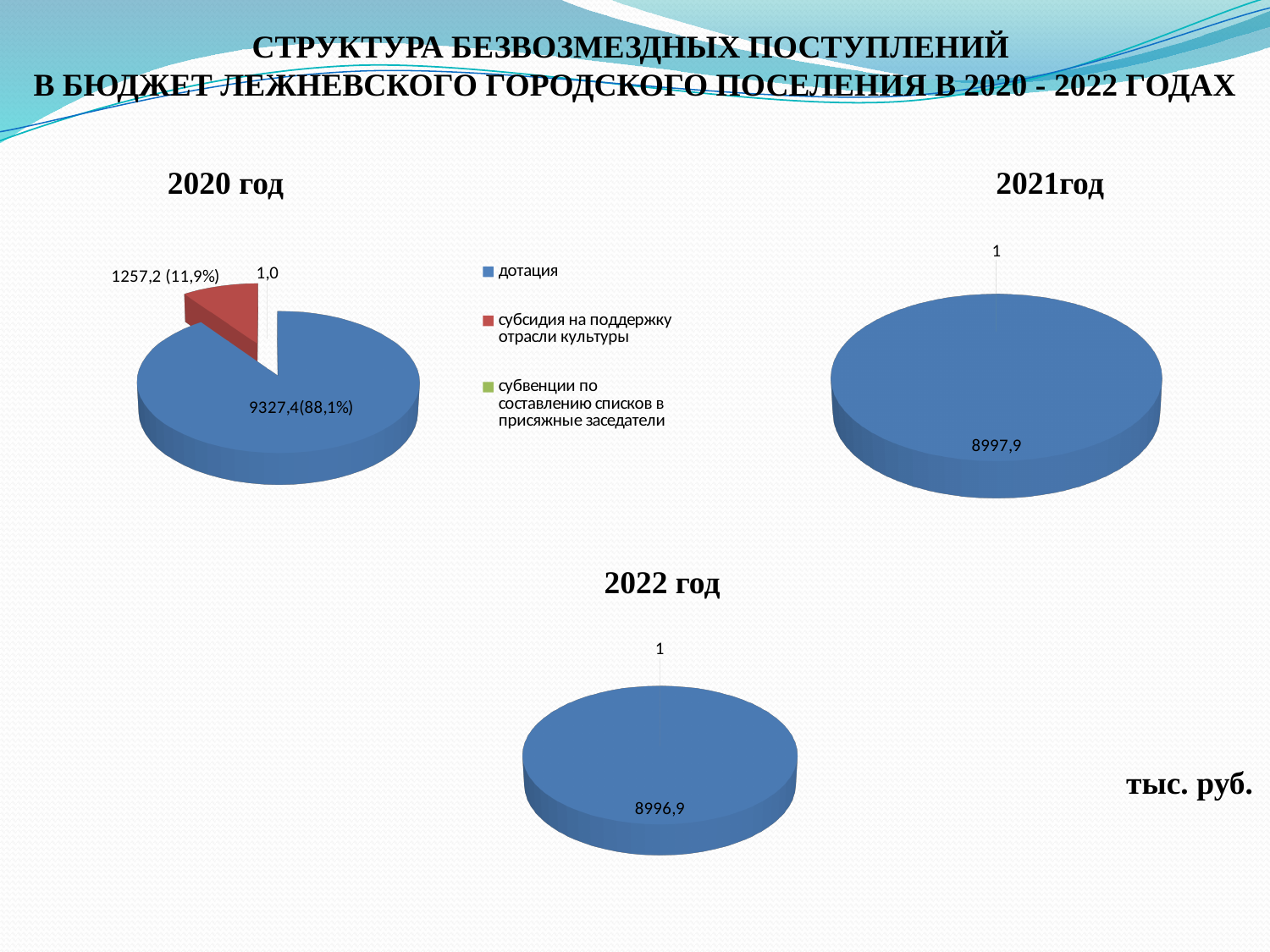
In the 2022 год chart, what is the value shown for дотация? 8996,9 In the 2020 год chart, what share of the pie does субсидия на поддержку отрасли культуры take? 11,9% How many entries does the legend list? 3 What is the difference between дотация in the 2021год chart and дотация in the 2022 год chart? 1,0 Which is larger: дотация in the 2021год chart or дотация in the 2022 год chart? 2021год In the 2020 год chart, what share of the pie does дотация take? 88,1% In the 2020 год chart, what is the value shown for субсидия на поддержку отрасли культуры? 1257,2 (11,9%) What kind of chart is used for 2020 год? pie chart In the 2021год chart, what is the value shown for дотация? 8997,9 In the 2020 год chart, what is the value shown for дотация? 9327,4(88,1%) In the 2020 год chart, which category has the largest slice? дотация In the 2022 год chart, what is the value shown for субвенции по составлению списков в присяжные заседатели? 1